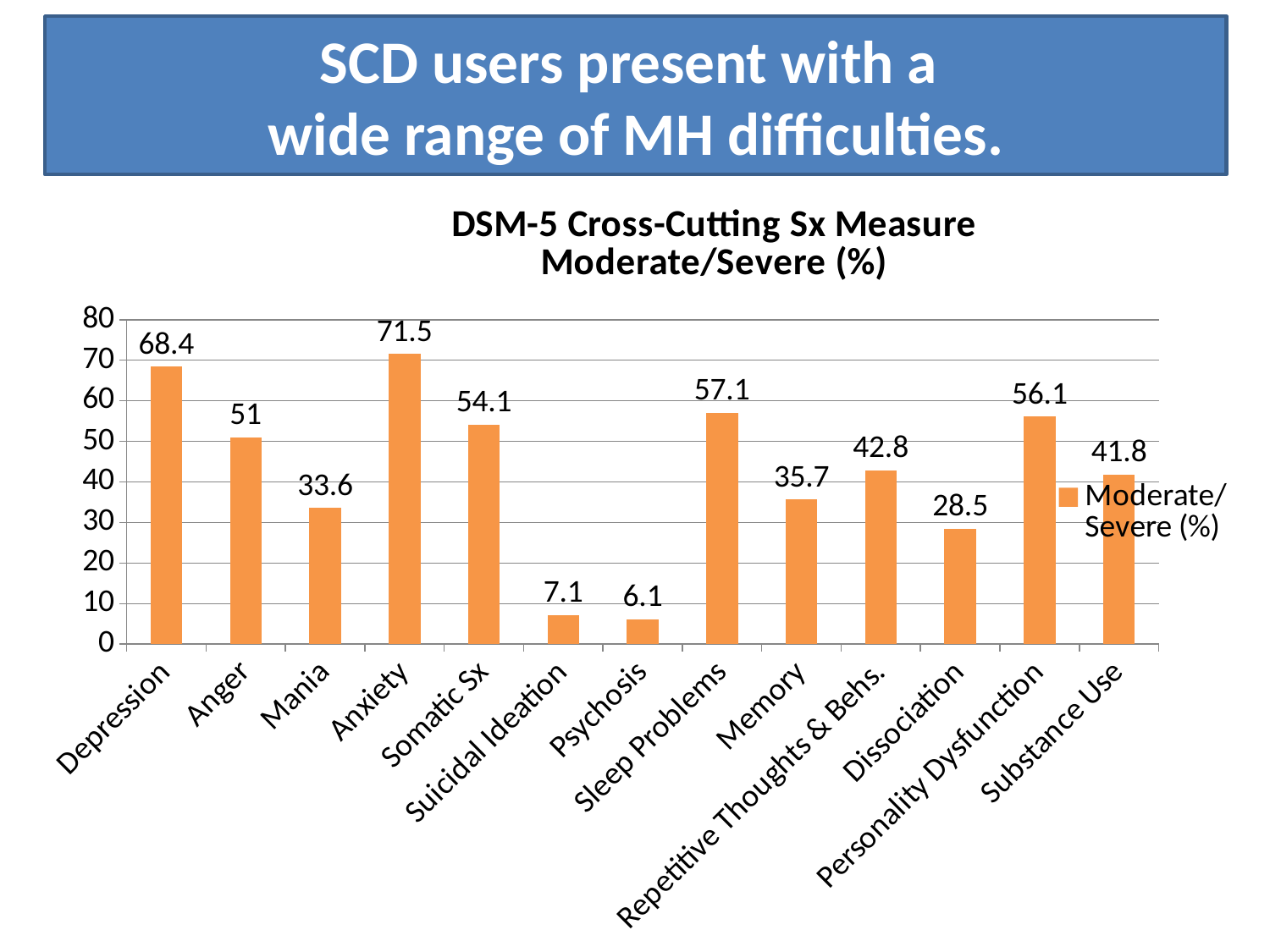
Which is larger, the value for Personality Dysfunction or the value for Somatic Sx? Personality Dysfunction What is the value for Sleep Problems? 57.1 What is the value for Depression? 68.4 What is the value for Dissociation? 28.5 How many series does the legend list? 1 Is the value for Memory greater or less than 40? less How many categories are shown on the x axis? 13 What kind of chart is shown? bar chart Which category has the highest value? Anxiety What is the difference between the values for Suicidal Ideation and Psychosis? 1 Which category has the lowest value? Psychosis What is the difference between the values for Anxiety and Depression? 3.1